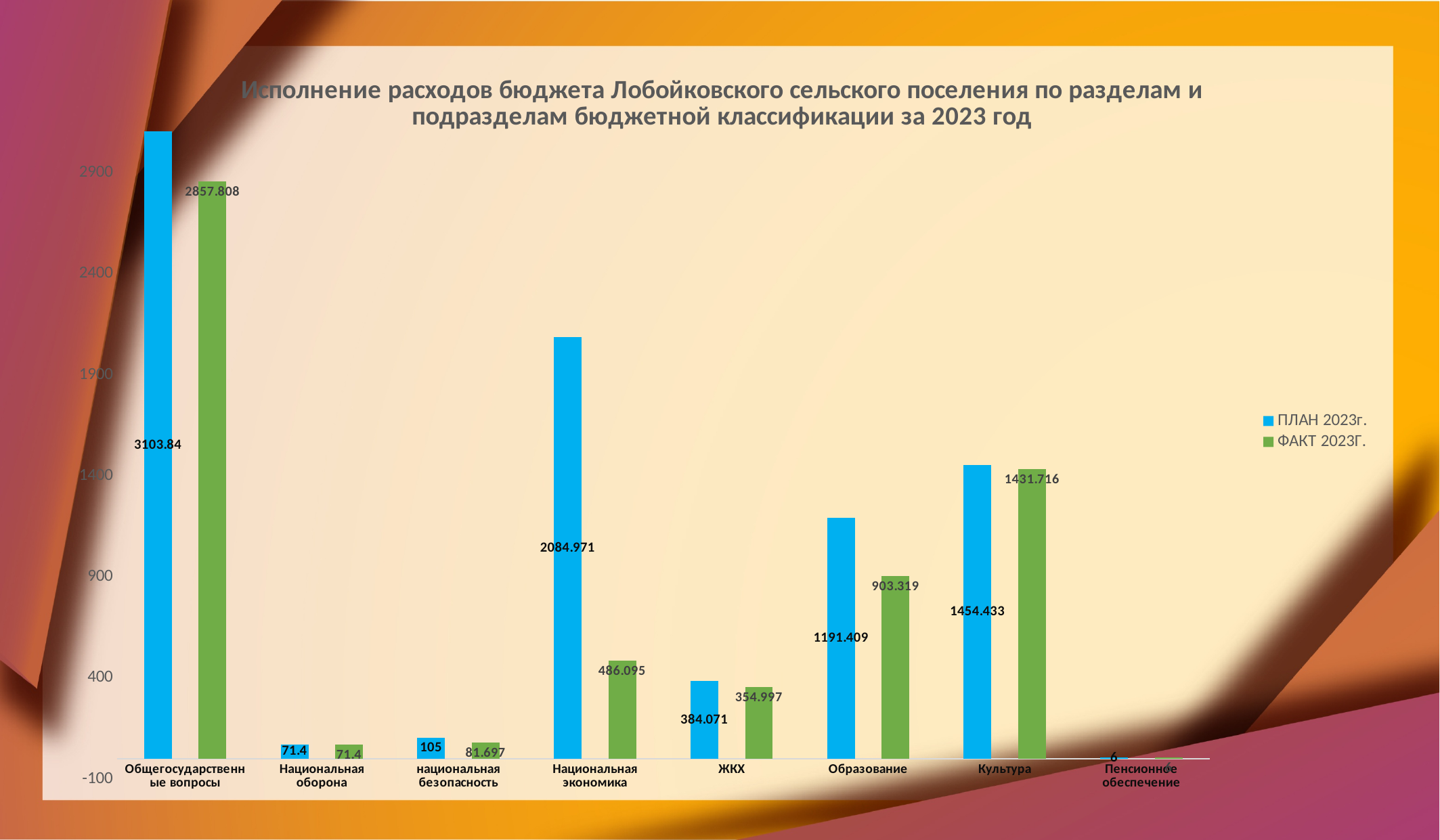
How many series does the legend list? 2 What is the ПЛАН 2023г. value for Национальная экономика? 2084.971 How many categories are shown on the x axis? 8 Which category has the lowest ПЛАН 2023г. value? Пенсионное обеспечение What is the difference between the ПЛАН 2023г. and ФАКТ 2023Г. values for Общегосударственные вопросы? 246.032 What colour represents the ПЛАН 2023г. series in the legend? blue What is the ФАКТ 2023Г. value for Образование? 903.319 What kind of chart is shown on the slide? bar chart Which category has the highest ФАКТ 2023Г. value? Общегосударственные вопросы What is the difference between the ПЛАН 2023г. and ФАКТ 2023Г. values for Культура? 22.717 For Национальная экономика, which is larger: the ПЛАН 2023г. value or the ФАКТ 2023Г. value? ПЛАН 2023г. What is the ФАКТ 2023Г. value for ЖКХ? 354.997